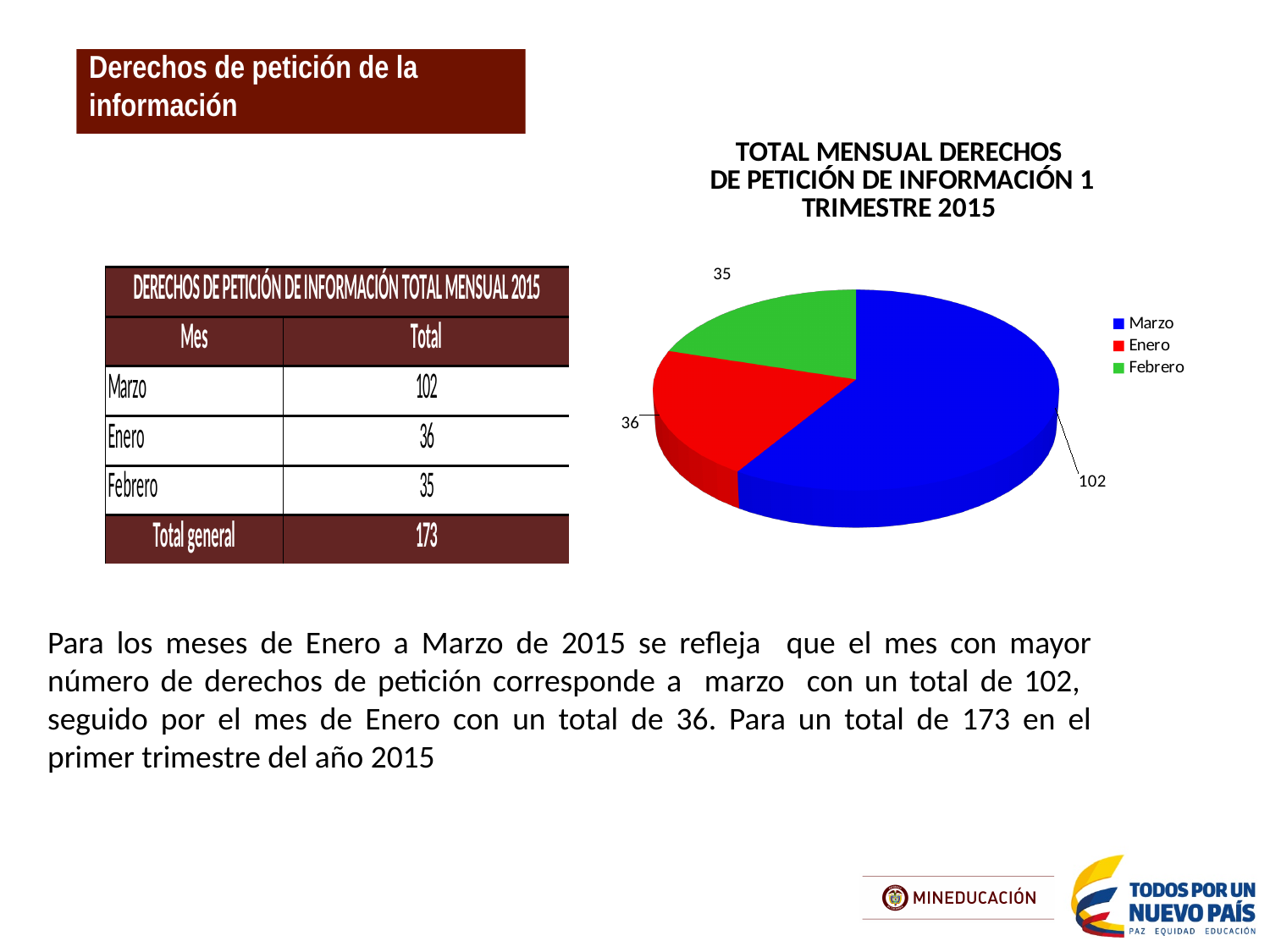
What is the value for Febrero in the pie chart? 35 What is the total of all slices in the pie chart? 173 What is the value for Enero in the pie chart? 36 Which month has the smallest slice in the pie chart? Febrero How many slices does the pie chart have? 3 What colour is the Marzo slice in the pie chart? blue What kind of chart is shown on the slide? pie chart What is the difference between the values for Enero and Febrero? 1 What is the value for Marzo in the pie chart? 102 What is the difference between the values for Marzo and Enero? 66 Which is larger, the value for Enero or the value for Febrero? Enero Which month has the largest slice in the pie chart? Marzo